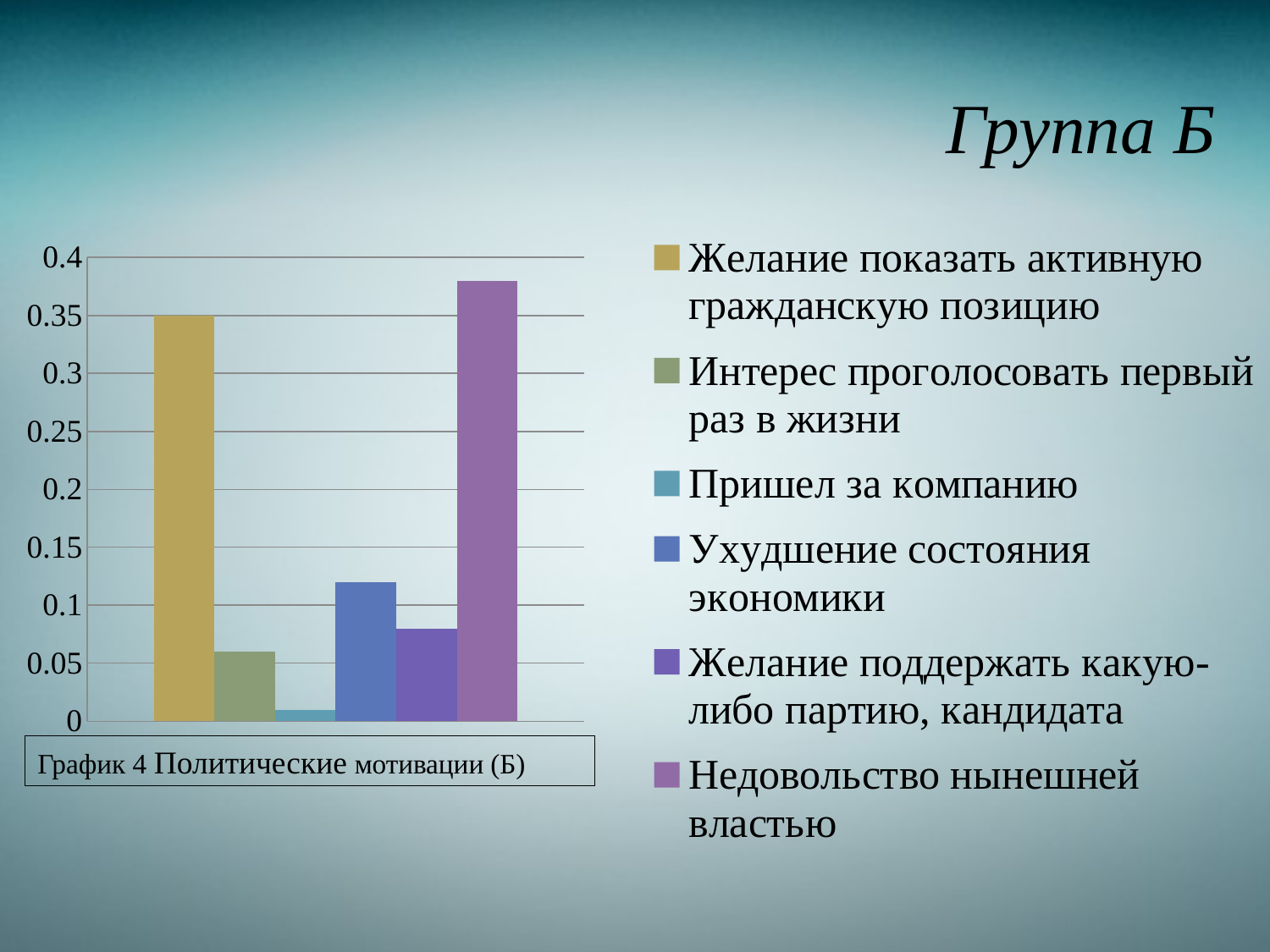
Is the value for "Пришел за компанию" greater or less than 0.05? less Is the value for "Интерес проголосовать первый раз в жизни" greater or less than 0.1? less Is the value for "Ухудшение состояния экономики" greater or less than 0.1? greater What kind of chart is shown on the slide? bar chart Which series has the lowest value? Пришел за компанию What colour is the bar for "Недовольство нынешней властью"? purple Which is larger: the value for "Ухудшение состояния экономики" or the value for "Желание поддержать какую-либо партию, кандидата"? Ухудшение состояния экономики What is the value for "Желание показать активную гражданскую позицию"? 0.35 How many series does the legend list? 6 What is the caption shown below the chart? График 4 Политические мотивации (Б) Which series has the highest value? Недовольство нынешней властью